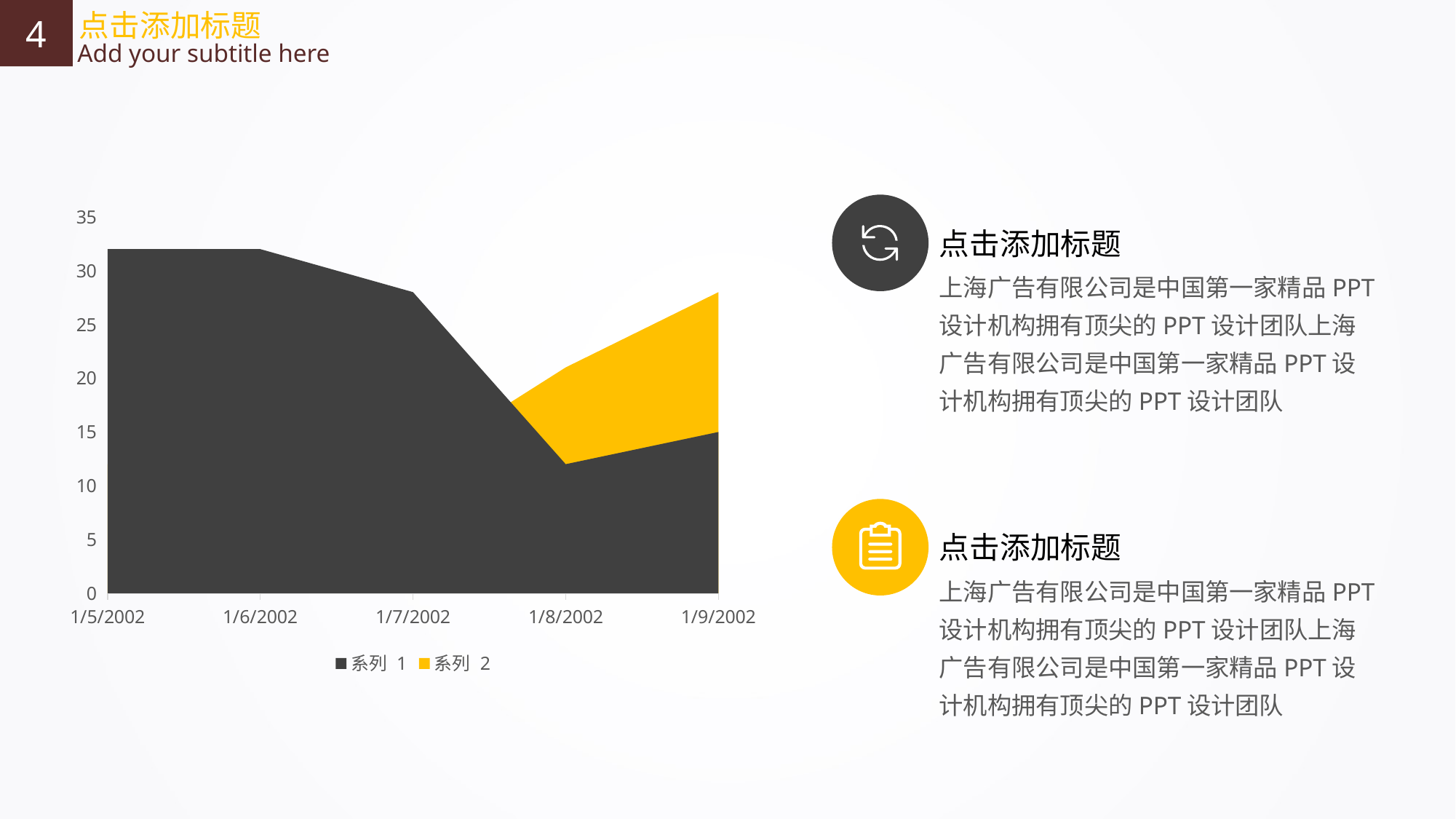
Does 系列 1 rise or fall from 1/6/2002 to 1/8/2002? fall How many series does the chart legend list? 2 Which is larger for 系列 1: the value at 1/5/2002 or the value at 1/8/2002? 1/5/2002 Is the value for 系列 1 at 1/8/2002 greater or less than 15? less What are the two legend entries of the chart? 系列 1 and 系列 2 Is the value for 系列 1 at 1/7/2002 greater or less than 25? greater How many dates are shown on the x axis of the chart? 5 Is the value for 系列 2 at 1/9/2002 greater or less than 25? greater What kind of chart is shown on the slide? area chart What colour is 系列 2 drawn in? yellow At which date does 系列 1 reach its lowest value? 1/8/2002